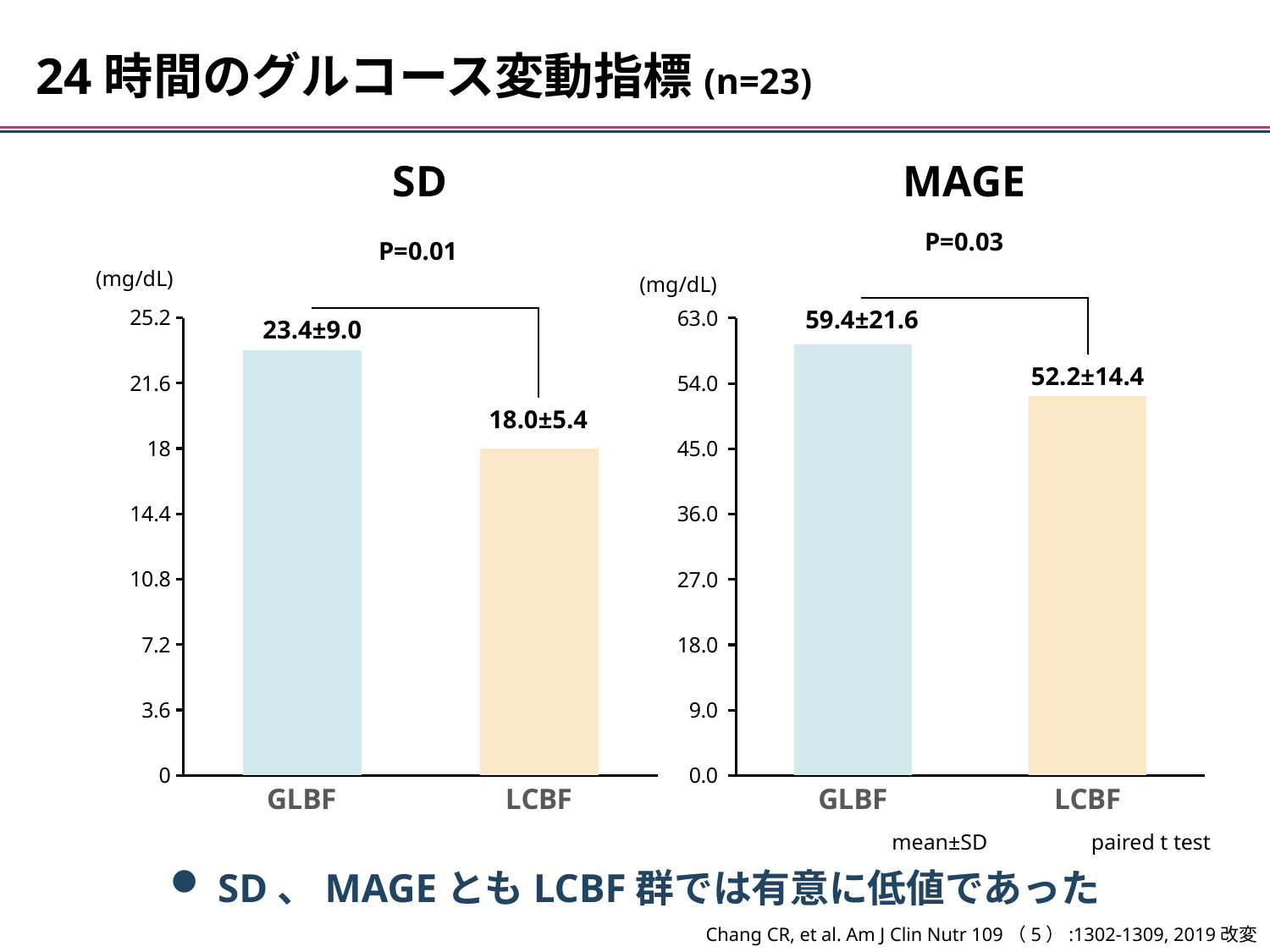
In the MAGE chart, what is the value shown for LCBF? 52.2±14.4 In the SD chart, what is the difference between the mean values for GLBF and LCBF? 5.4 In the SD chart, what is the value shown for GLBF? 23.4±9.0 In the SD chart, what is the value shown for LCBF? 18.0±5.4 In the MAGE chart, what is the difference between the mean values for GLBF and LCBF? 7.2 In the MAGE chart, is the mean value for LCBF greater or less than 54.0? less What P value is shown above the SD chart? P=0.01 In the MAGE chart, which group has the lower bar? LCBF In the SD chart, which group has the higher bar? GLBF What type of chart is the MAGE chart? bar chart How many bars are plotted in the SD chart? 2 In the MAGE chart, what is the value shown for GLBF? 59.4±21.6